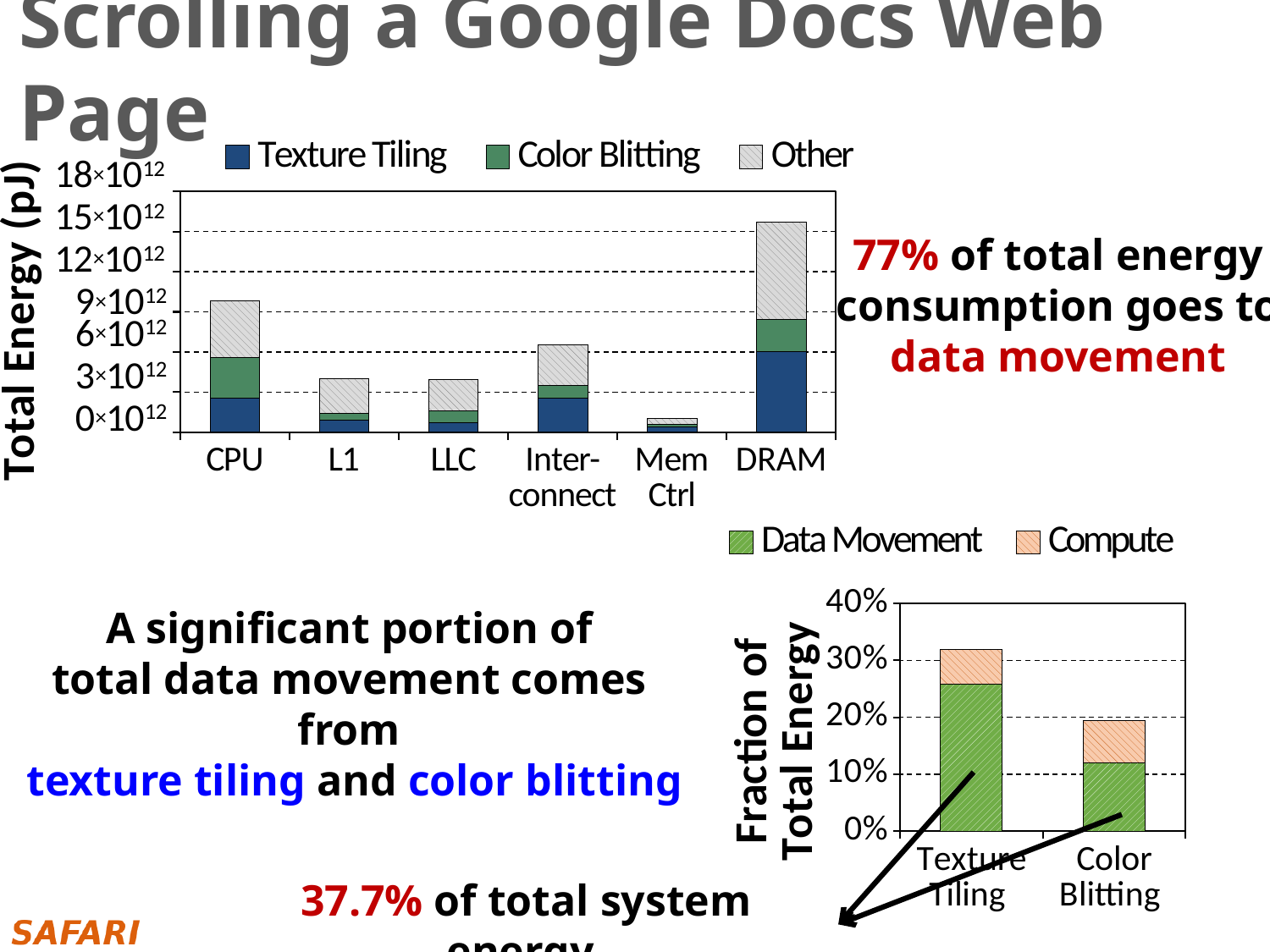
In the top chart (Total Energy), which has a larger total energy, CPU or LLC? CPU What kind of chart is the bottom chart (Fraction of Total Energy)? stacked bar chart In the top chart (Total Energy), is the total value for L1 greater or less than 6×10^12? less In the bottom chart (Fraction of Total Energy), which category has the larger total fraction, Texture Tiling or Color Blitting? Texture Tiling In the top chart (Total Energy), which category has the highest total energy? DRAM How many categories are shown on the x axis of the top chart (Total Energy)? 6 What are the two series listed in the legend of the bottom chart (Fraction of Total Energy)? Data Movement and Compute In the top chart (Total Energy), is the total value for Mem Ctrl greater or less than 3×10^12? less In the top chart (Total Energy), which category has the lowest total energy? Mem Ctrl How many series does the legend of the top chart (Total Energy) list? 3 In the top chart (Total Energy), is the total value for DRAM greater or less than 12×10^12? greater